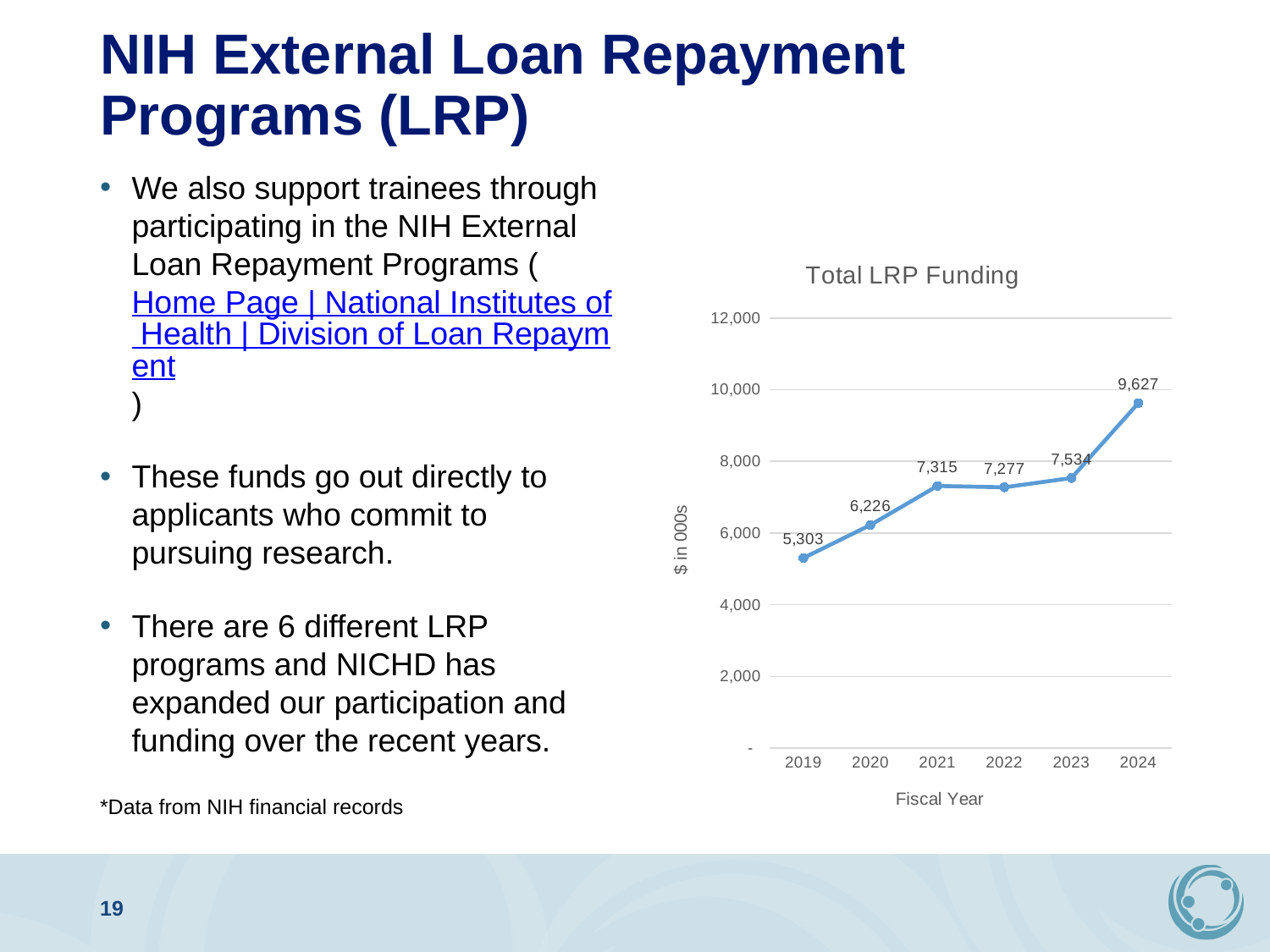
Which fiscal year has the highest Total LRP Funding? 2024 What is the difference in Total LRP Funding between 2020 and 2019? 923 What is the Total LRP Funding value for fiscal year 2022? 7,277 What kind of chart is used to show Total LRP Funding? line chart How many fiscal years are plotted in the Total LRP Funding chart? 6 Is the Total LRP Funding value for 2023 greater or less than 8,000? less What is the Total LRP Funding value for fiscal year 2024? 9,627 What is the Total LRP Funding value for fiscal year 2019? 5,303 What is the label on the y axis of the Total LRP Funding chart? $ in 000s Which fiscal year has higher Total LRP Funding, 2021 or 2020? 2021 What is the difference in Total LRP Funding between 2024 and 2023? 2,093 Which fiscal year has the lowest Total LRP Funding? 2019